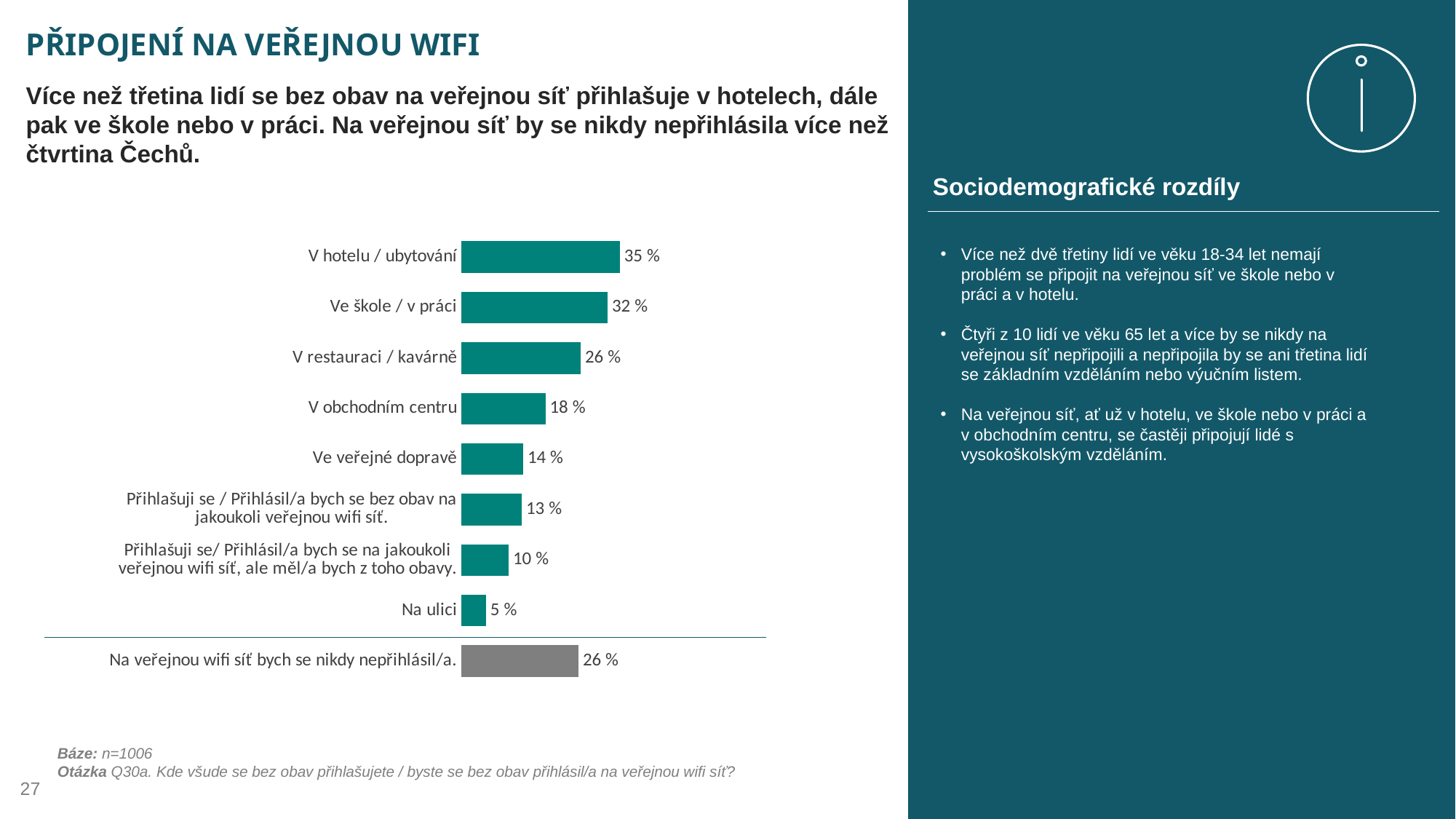
Which category has the highest value? V hotelu / ubytování How many bars are shown in the chart? 9 What is the value for "V obchodním centru"? 18 % What is the value for "Na veřejnou wifi síť bych se nikdy nepřihlásil/a."? 26 % What is the value for "Ve škole / v práci"? 32 % What is the value for "V hotelu / ubytování"? 35 % Which category has the lowest value? Na ulici What type of chart is shown on the slide? Bar chart Which bar is coloured grey instead of teal? Na veřejnou wifi síť bych se nikdy nepřihlásil/a. What is the difference between the values for "V hotelu / ubytování" and "Ve škole / v práci"? 3 percentage points Which is larger: the value for "Ve veřejné dopravě" or the value for "V obchodním centru"? V obchodním centru What is the value for "Na ulici"? 5 %